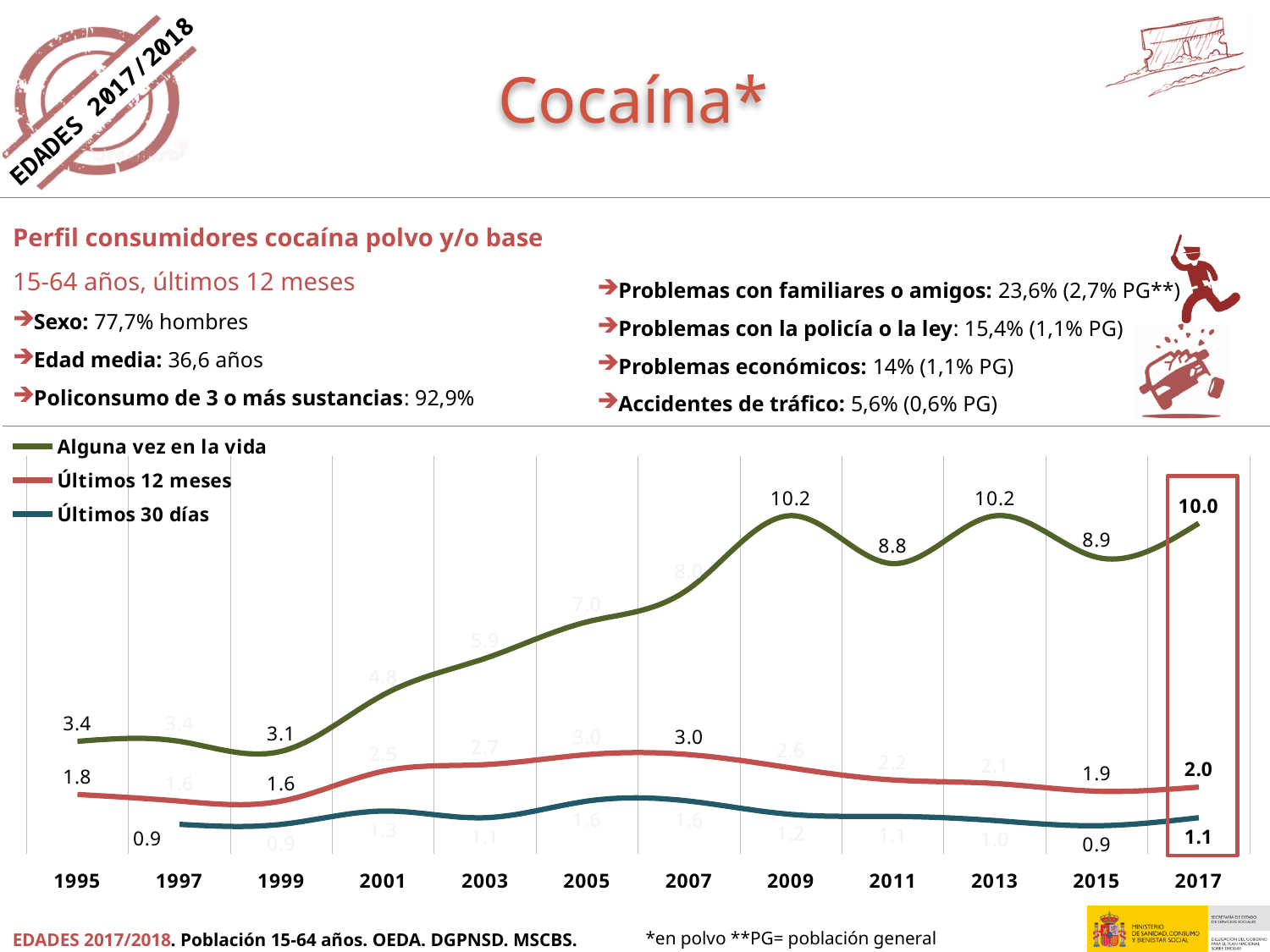
What is the value for 'Últimos 30 días' in 2017? 1.1 What is the value for 'Alguna vez en la vida' in 2017? 10.0 For 'Últimos 12 meses', which year has the larger value, 2007 or 2017? 2007 Does the 'Alguna vez en la vida' series rise or fall overall from 1995 to 2017? rise What kind of chart is shown on the slide? line chart What is the value for 'Últimos 12 meses' in 2017? 2.0 What colour is the 'Alguna vez en la vida' line in the chart? green What is the difference between the 'Últimos 12 meses' values for 2007 and 2017? 1.0 How many series does the chart legend list? 3 How many years are shown on the x axis of the chart? 12 What is the value for 'Alguna vez en la vida' in 2009? 10.2 What is the difference between the 'Alguna vez en la vida' values for 2013 and 2011? 1.4